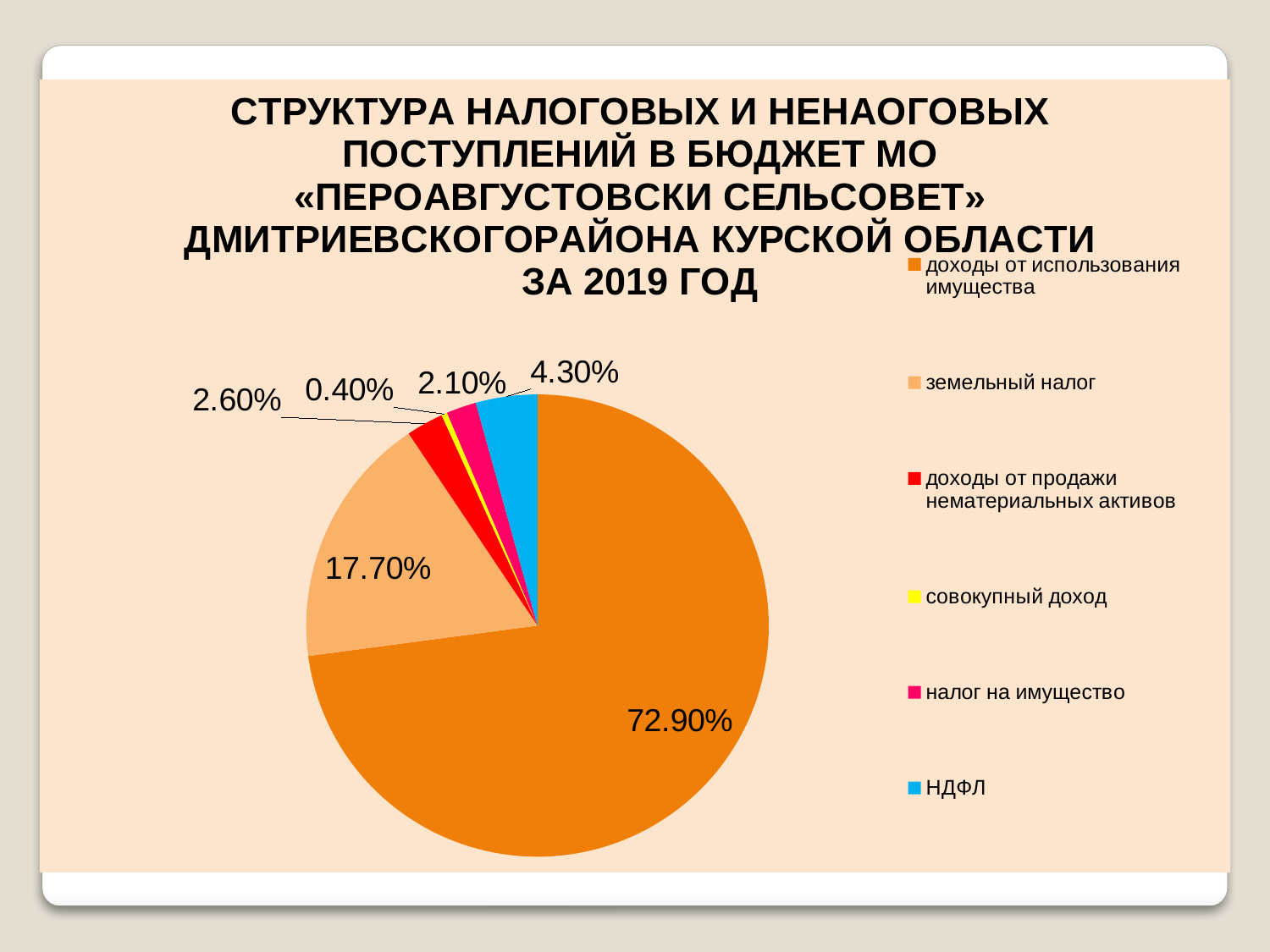
What share of the pie does «налог на имущество» have? 2.10% How many slices does the pie chart have? 6 What share of the pie does «земельный налог» have? 17.70% What share of the pie does «совокупный доход» have? 0.40% Which category has the largest share of the pie? доходы от использования имущества What colour is the slice for «НДФЛ»? blue What share of the pie does «доходы от использования имущества» have? 72.90% What kind of chart is shown on the slide? pie chart What is the difference between the shares of «земельный налог» and «НДФЛ»? 13.40% Which is larger: the share of «доходы от продажи нематериальных активов» or the share of «налог на имущество»? доходы от продажи нематериальных активов Which category has the smallest share of the pie? совокупный доход What share of the pie does «НДФЛ» have? 4.30%